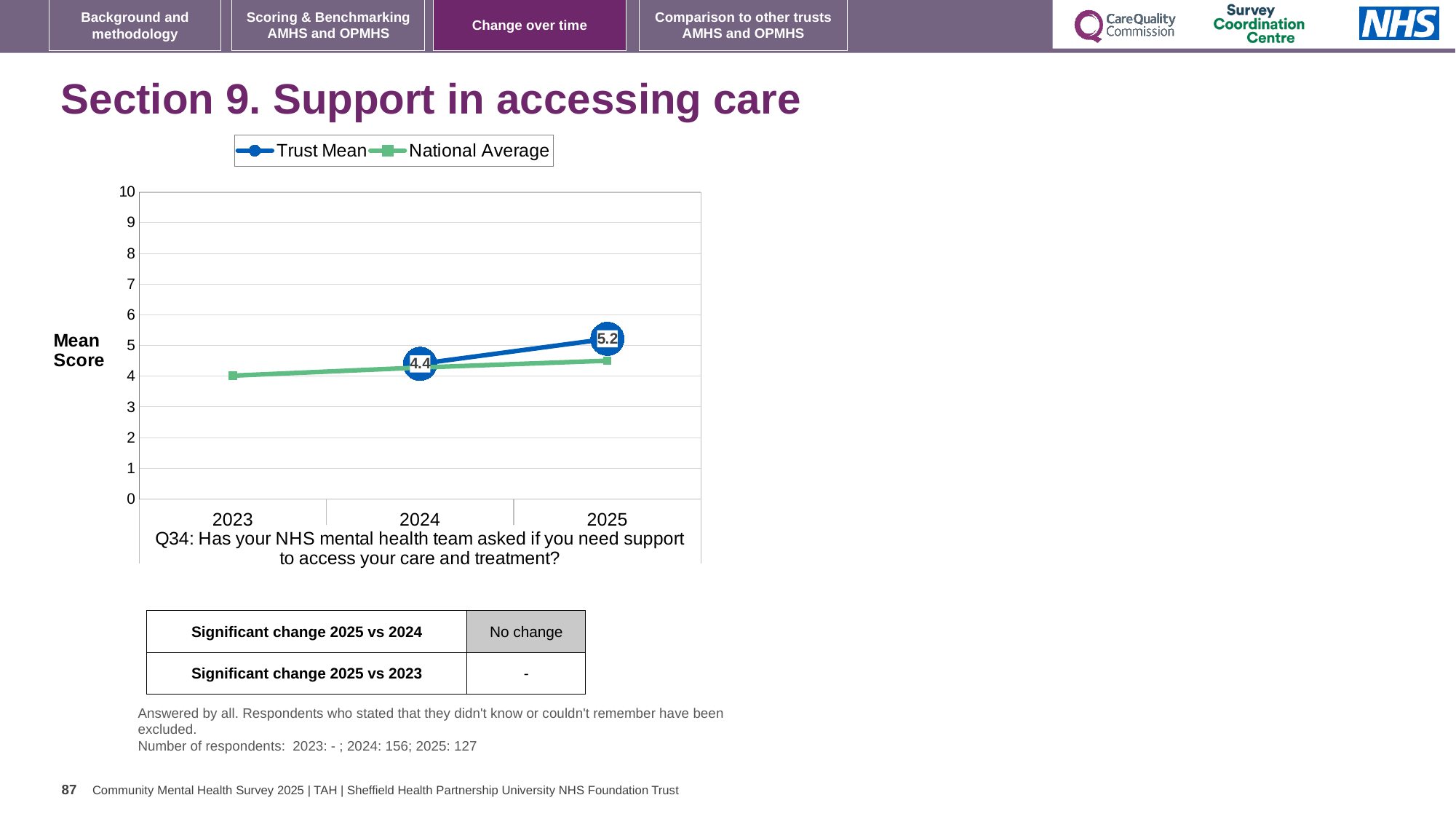
What kind of chart is shown on the slide? line chart By how much did the Trust Mean change from 2024 to 2025? 0.8 What is the label on the y axis of the chart? Mean Score What is the Trust Mean score for 2024? 4.4 What is the Trust Mean score for 2025? 5.2 Is the National Average for 2023 greater or less than 5? less How many years are shown on the x axis? 3 Is the Trust Mean for 2025 greater or less than 5? greater Did the Trust Mean rise or fall from 2024 to 2025? rise In 2025, which is larger: the Trust Mean or the National Average? Trust Mean How many series does the legend list? 2 In which year is the Trust Mean highest? 2025